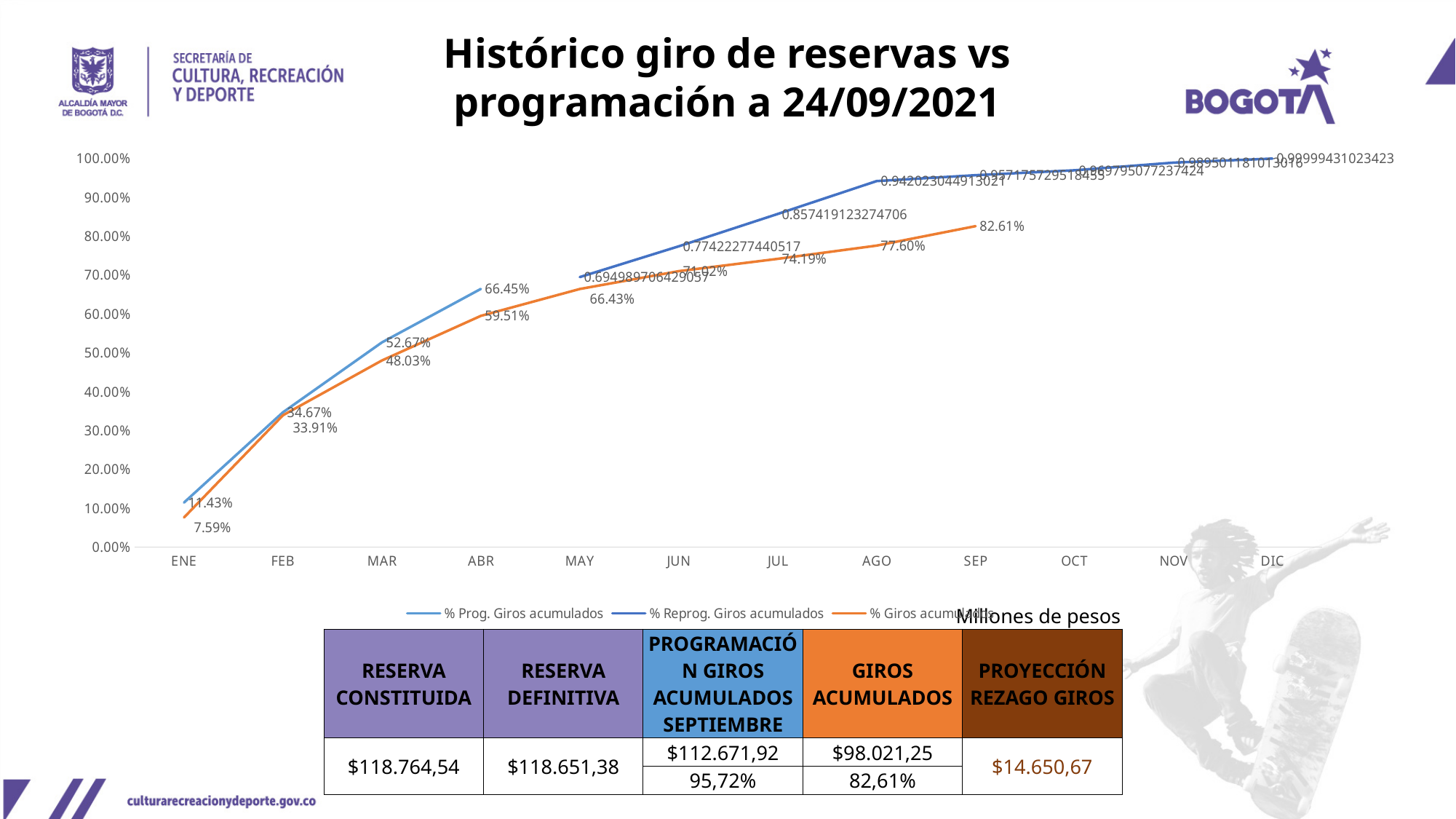
Does the % Giros acumulados line rise or fall from ENE to SEP? Rises What is the value of % Giros acumulados in SEP? 82.61% How many months are shown on the x axis of the chart? 12 What is the value of % Giros acumulados in JUL? 74.19% In which month does % Giros acumulados reach its highest value? SEP What is the difference between % Prog. Giros acumulados and % Giros acumulados in ABR? 6.94 percentage points What kind of chart is shown on the slide? Line chart How many series does the chart legend list? 3 Is the value of % Reprog. Giros acumulados in AGO greater or less than 90%? greater What is the value of % Prog. Giros acumulados in ABR? 66.45% What is the value of % Giros acumulados in ENE? 7.59% In MAR, which is higher: % Prog. Giros acumulados or % Giros acumulados? % Prog. Giros acumulados